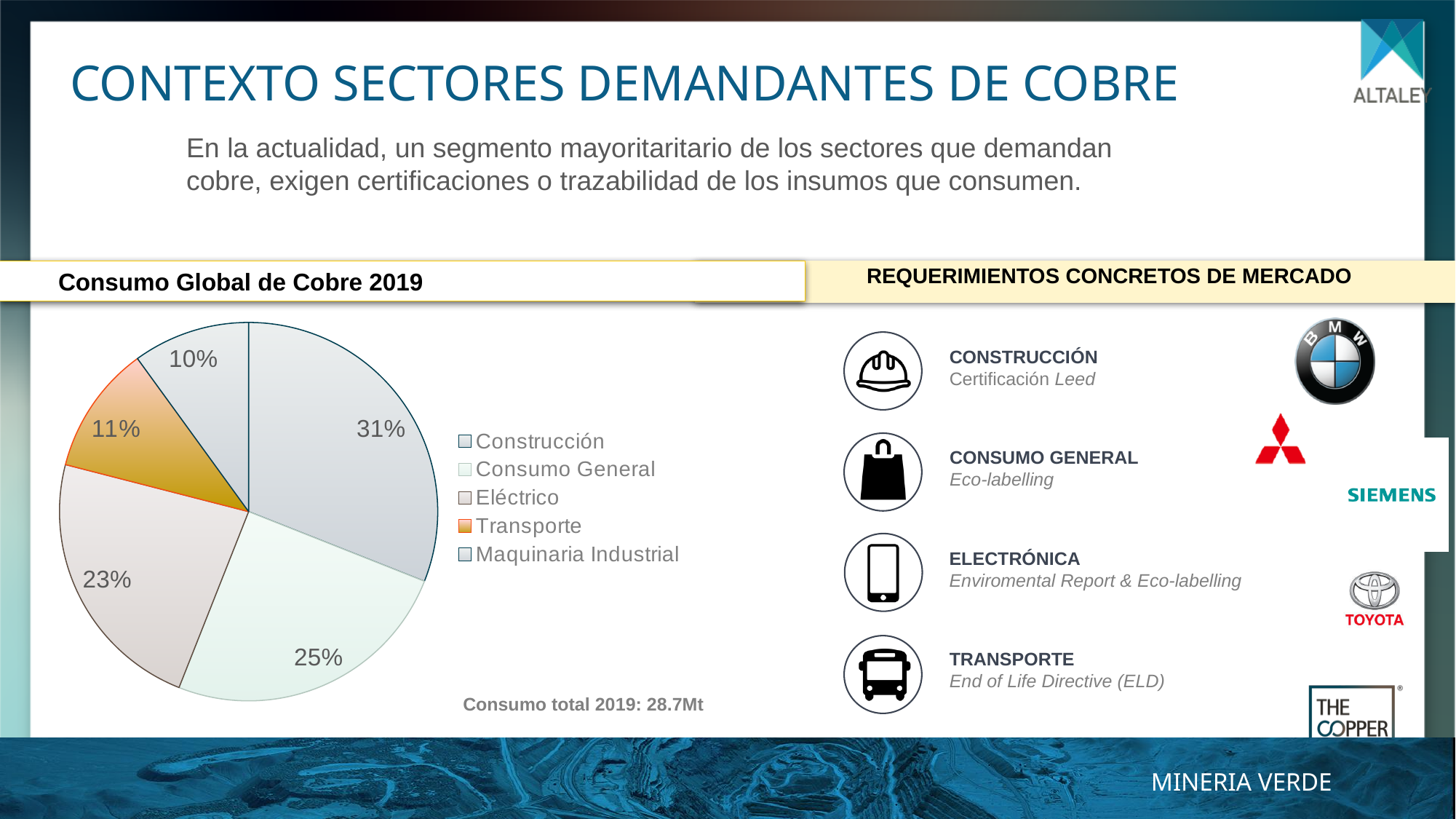
Which is larger in the pie chart, Consumo General or Transporte? Consumo General What is the difference in percentage points between Construcción and Eléctrico in the pie chart? 8 What percentage does Transporte represent in the pie chart? 11% Which sector has the smallest slice in the pie chart? Maquinaria Industrial What total copper consumption for 2019 is stated below the pie chart? 28.7Mt What is the share of Eléctrico in the pie chart? 23% What percentage of the pie chart corresponds to Consumo General? 25% What type of chart is shown under the heading 'Consumo Global de Cobre 2019'? Pie chart Which sector has the largest slice in the pie chart? Construcción How many sectors are shown in the pie chart legend? 5